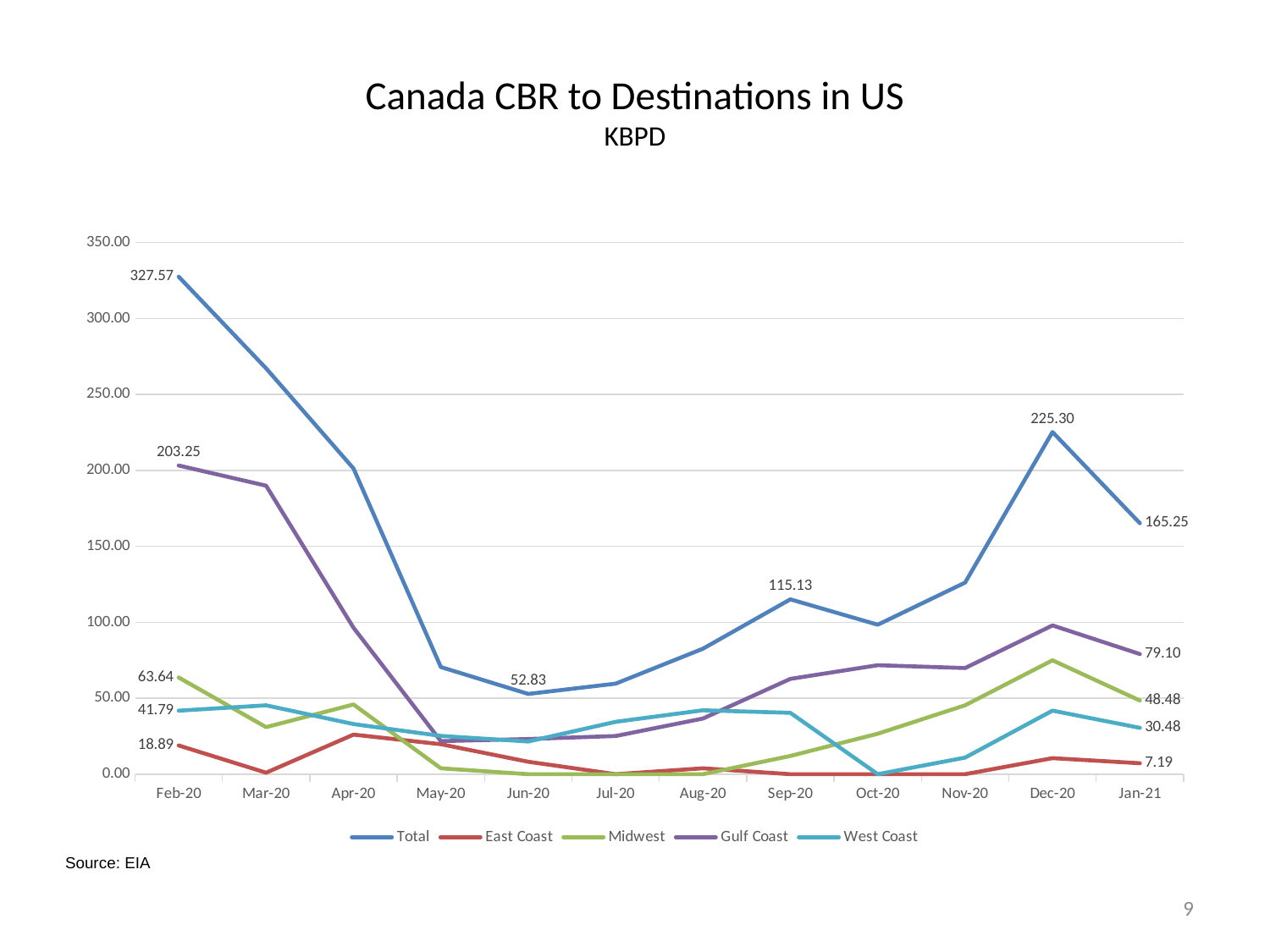
How many months are shown on the x axis? 12 How many series does the legend list? 5 In which month is the Total lowest? Jun-20 In Jan-21, which is larger, Midwest or West Coast? Midwest What is the Total value for Feb-20? 327.57 In which month is the Total highest? Feb-20 What is the East Coast value for Feb-20? 18.89 By how much did the Total fall from Feb-20 to Jan-21? 162.32 Is the Total value for Apr-20 greater or less than 150.00? greater What is the Total value for Dec-20? 225.30 What kind of chart is shown on the slide? line chart What is the Gulf Coast value for Jan-21? 79.10